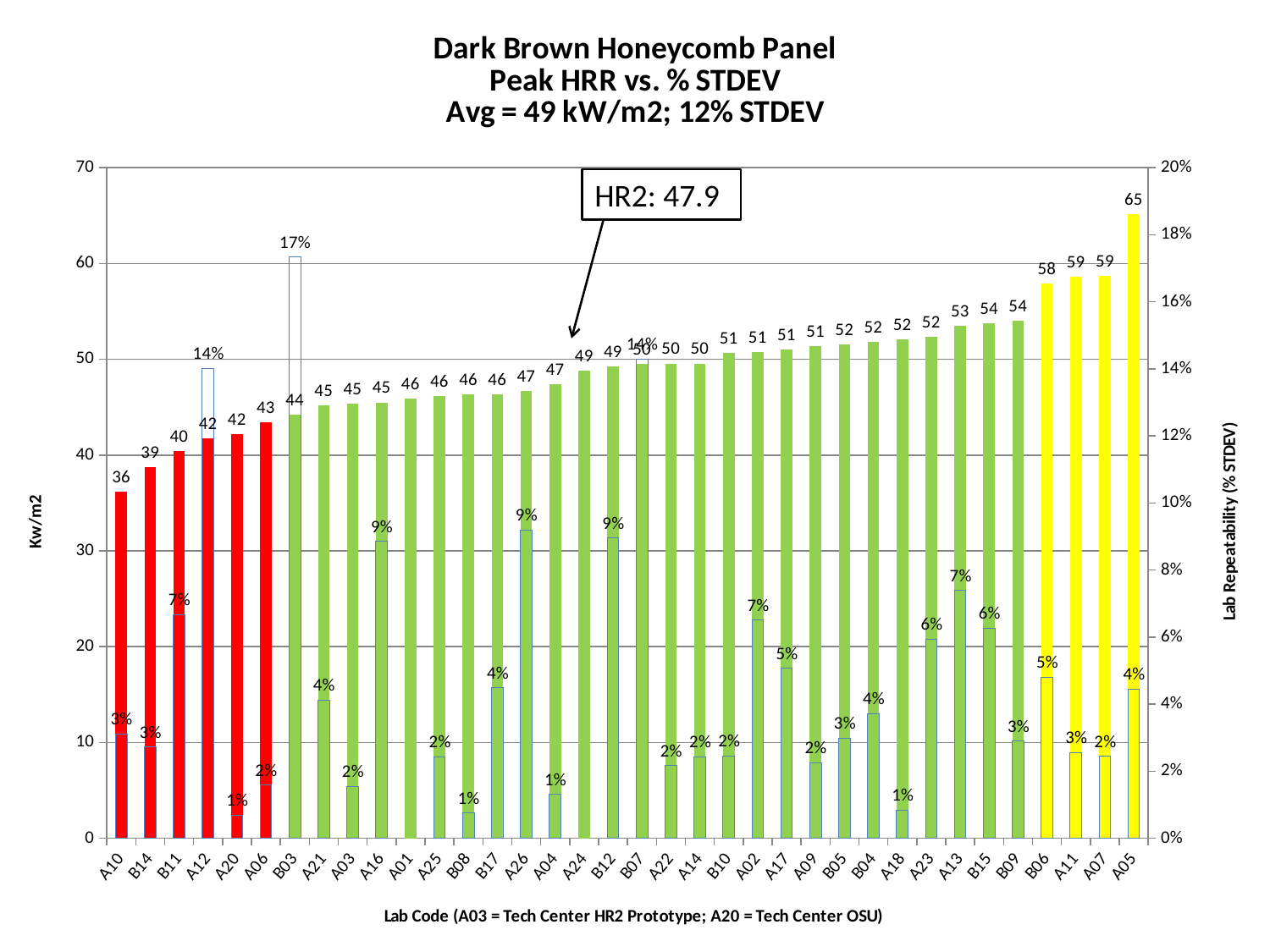
Do the peak HRR values rise or fall from left to right along the x axis? Rise What is the % STDEV value shown for lab A16? 9% What is the difference between the peak HRR values of A05 and A10? 29 What kind of chart is this? Bar chart Which lab code has the lowest peak HRR value? A10 How many lab codes are shown on the x axis? 36 What is the peak HRR value for lab B09? 54 Which has a higher peak HRR value, B06 or A06? B06 Which lab code has the highest peak HRR value? A05 What is the % STDEV value shown for lab B03? 17% What is the peak HRR value for lab A10? 36 What value is shown in the HR2 callout box on the chart? 47.9